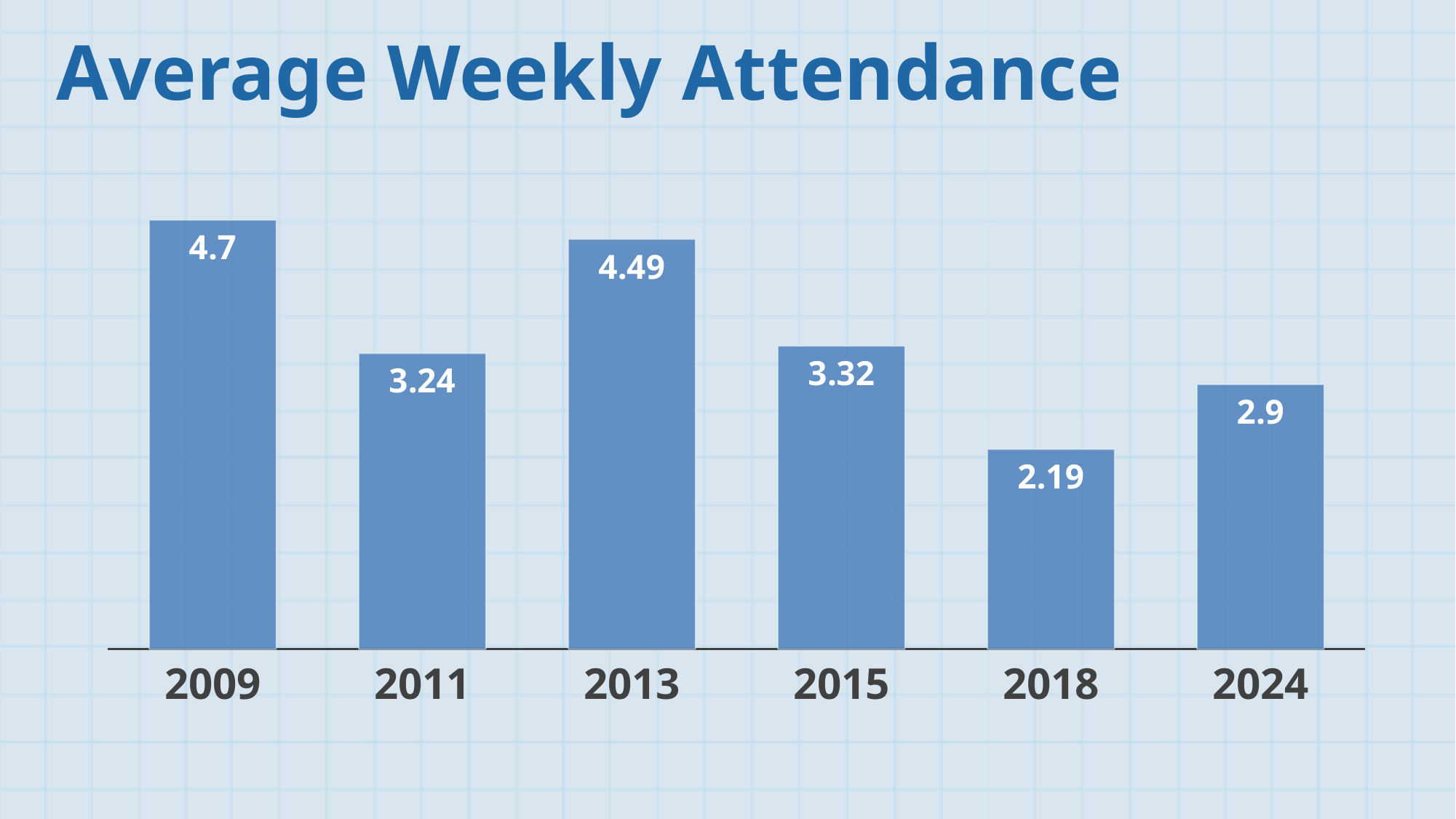
What is the title of the chart? Average Weekly Attendance What is the average weekly attendance value shown for 2009? 4.7 What is the difference between the values for 2015 and 2018? 1.13 Which year has the larger value, 2011 or 2015? 2015 What is the value shown for 2024? 2.9 Which year has the lowest average weekly attendance? 2018 What kind of chart is shown on the slide? Bar chart Which year has the highest average weekly attendance? 2009 What is the value shown for 2018? 2.19 Which year has the larger value, 2018 or 2024? 2024 How many years are shown on the x axis? 6 What is the difference between the values for 2009 and 2013? 0.21